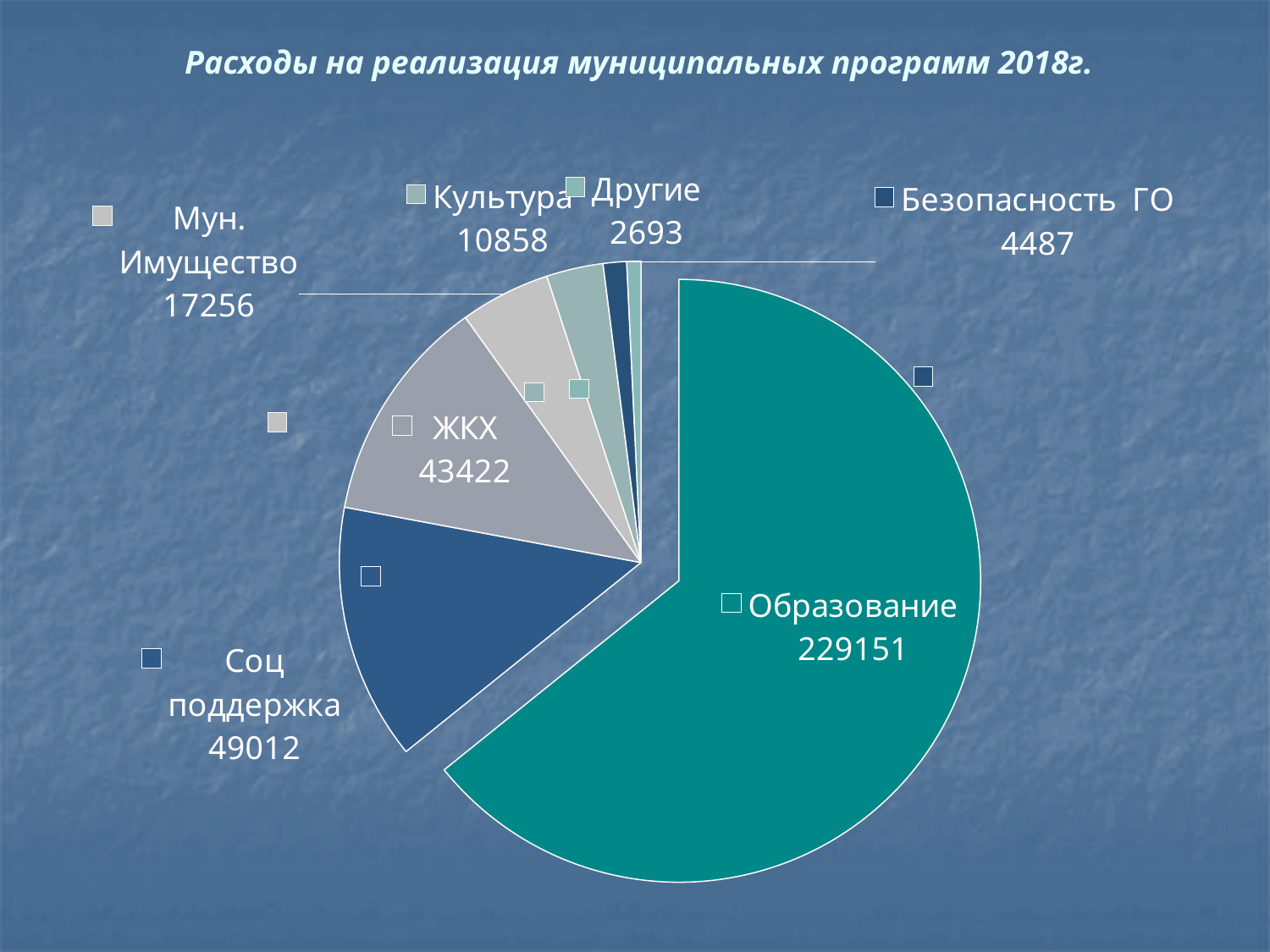
Which category has the smallest slice of the pie? Другие Which is larger, the value for Культура or the value for Безопасность ГО? Культура What is the value for Безопасность ГО? 4487 What is the value for Соц поддержка? 49012 What is the title of the chart? Расходы на реализация муниципальных программ 2018г. How many categories (slices) does the pie chart have? 7 What is the value for Мун. Имущество? 17256 What is the difference between the values for Соц поддержка and ЖКХ? 5590 What is the value for Образование? 229151 Which category has the largest slice of the pie? Образование What is the value for ЖКХ? 43422 What type of chart is shown on the slide? pie chart